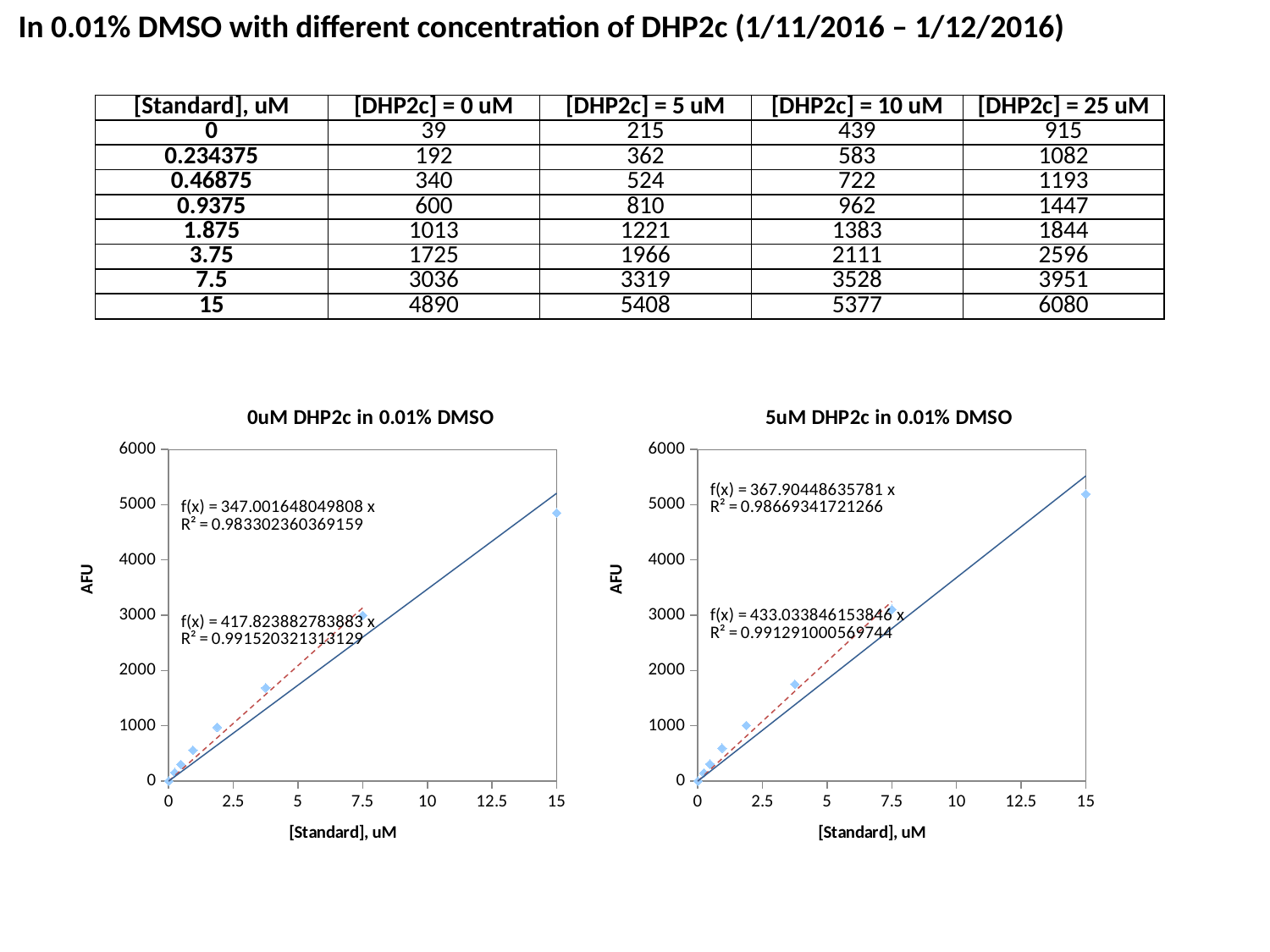
In the "0uM DHP2c in 0.01% DMSO" chart, do the AFU values rise or fall as the standard concentration increases? rise In the "5uM DHP2c in 0.01% DMSO" chart, is the AFU value at 15 uM standard greater or less than 5000? greater Which chart has the higher AFU value at 15 uM standard, "0uM DHP2c in 0.01% DMSO" or "5uM DHP2c in 0.01% DMSO"? 5uM DHP2c in 0.01% DMSO In the "0uM DHP2c in 0.01% DMSO" chart, what is the R² value of the dashed trendline? R² = 0.991520321313129 In the "5uM DHP2c in 0.01% DMSO" chart, what is the equation of the dashed trendline? f(x) = 433.033846153846 x What kind of chart is the "0uM DHP2c in 0.01% DMSO" chart? scatter chart In the "0uM DHP2c in 0.01% DMSO" chart, what is the equation of the solid trendline? f(x) = 347.001648049808 x What is the y-axis label of the "0uM DHP2c in 0.01% DMSO" chart? AFU In the "5uM DHP2c in 0.01% DMSO" chart, is the AFU value at 3.75 uM standard greater or less than 1000? greater In the "5uM DHP2c in 0.01% DMSO" chart, what is the R² value of the solid trendline? R² = 0.98669341721266 How many data points are plotted in the "5uM DHP2c in 0.01% DMSO" chart? 8 In the "0uM DHP2c in 0.01% DMSO" chart, is the AFU value at 15 uM standard greater or less than 5000? less